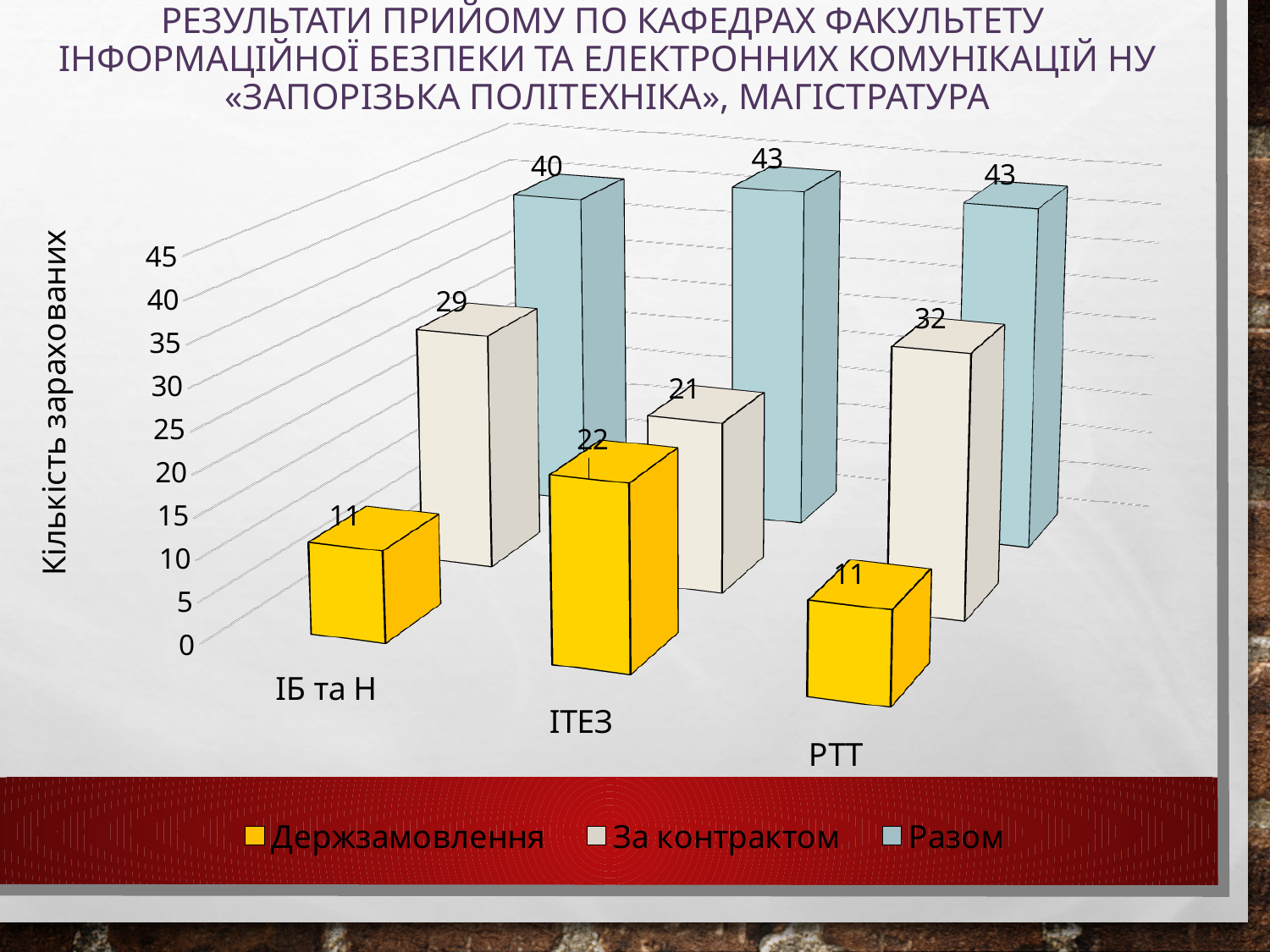
What is the value of За контрактом for ІБ та Н? 29 What is the label of the vertical axis? Кількість зарахованих Which is larger: Держзамовлення for ІТЕЗ or Держзамовлення for РТТ? Держзамовлення for ІТЕЗ How many categories are shown on the x axis? 3 What is the value of Разом for ІБ та Н? 40 What is the value of Держзамовлення for ІТЕЗ? 22 What is the difference between За контрактом for РТТ and За контрактом for ІБ та Н? 3 What kind of chart is shown on the slide? Bar chart Which category has the highest value for За контрактом? РТТ How many series does the legend list? 3 Which category has the lowest value for Разом? ІБ та Н What is the value of За контрактом for РТТ? 32